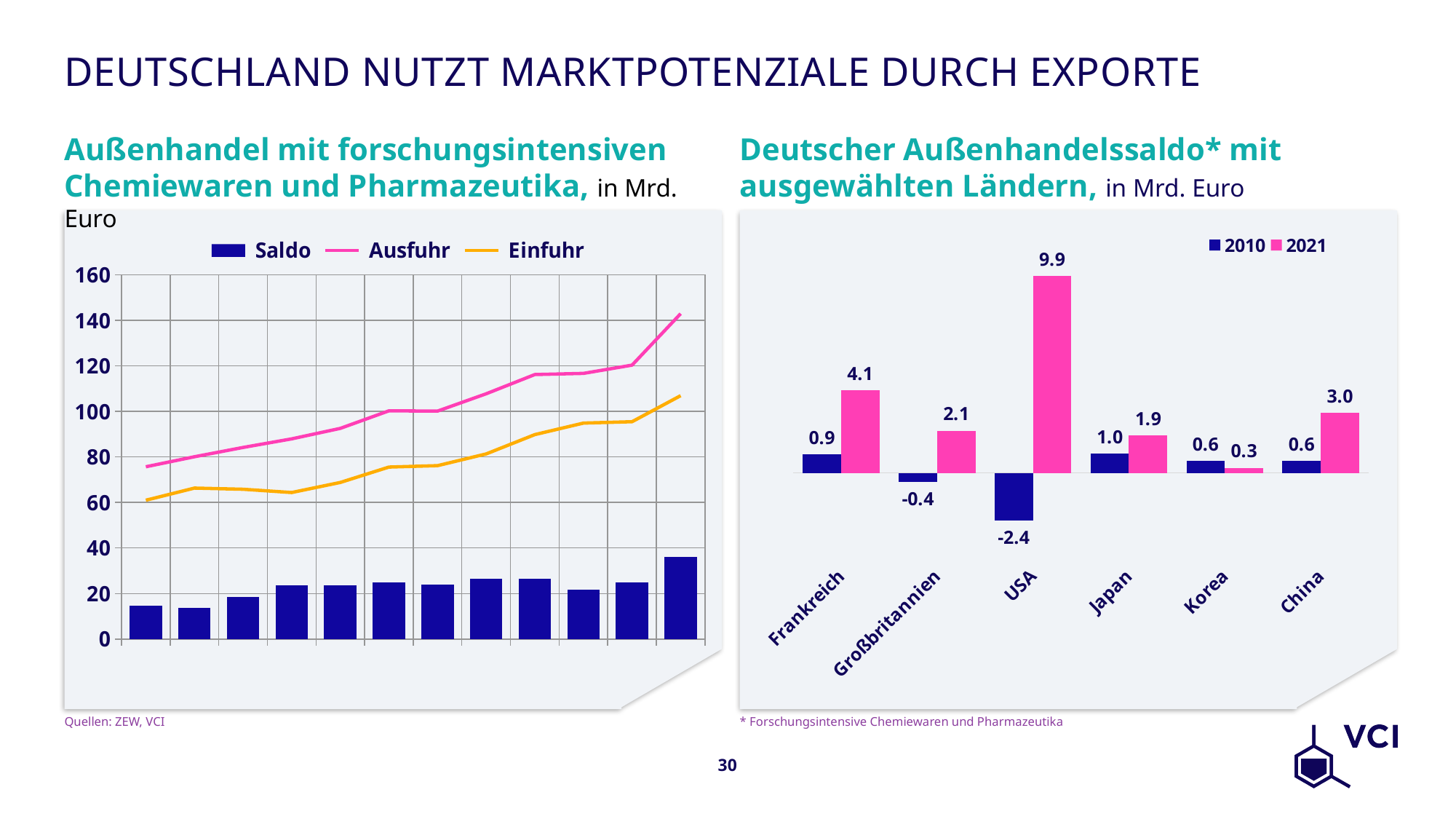
In the chart 'Deutscher Außenhandelssaldo mit ausgewählten Ländern', which country has the lowest value in 2010? USA In the chart 'Deutscher Außenhandelssaldo mit ausgewählten Ländern', what is the difference between the 2021 and 2010 values for Frankreich? 3.2 How many series does the legend of the left chart 'Außenhandel mit forschungsintensiven Chemiewaren und Pharmazeutika' list? 3 In the chart 'Deutscher Außenhandelssaldo mit ausgewählten Ländern', which is larger for Korea: the 2010 value or the 2021 value? 2010 In the chart 'Deutscher Außenhandelssaldo mit ausgewählten Ländern', what is the value for Großbritannien in 2010? -0.4 In the left chart 'Außenhandel mit forschungsintensiven Chemiewaren und Pharmazeutika', is the first value of the Einfuhr line greater or less than 80? less In the chart 'Deutscher Außenhandelssaldo mit ausgewählten Ländern', what is the value for USA in 2021? 9.9 In the chart 'Deutscher Außenhandelssaldo mit ausgewählten Ländern', what is the value for China in 2021? 3.0 How many countries are shown in the chart 'Deutscher Außenhandelssaldo mit ausgewählten Ländern'? 6 In the chart 'Deutscher Außenhandelssaldo mit ausgewählten Ländern', which country has the highest value in 2021? USA How many series does the legend of the chart 'Deutscher Außenhandelssaldo mit ausgewählten Ländern' list? 2 In the left chart 'Außenhandel mit forschungsintensiven Chemiewaren und Pharmazeutika', does the Ausfuhr line rise or fall along the x axis? rise